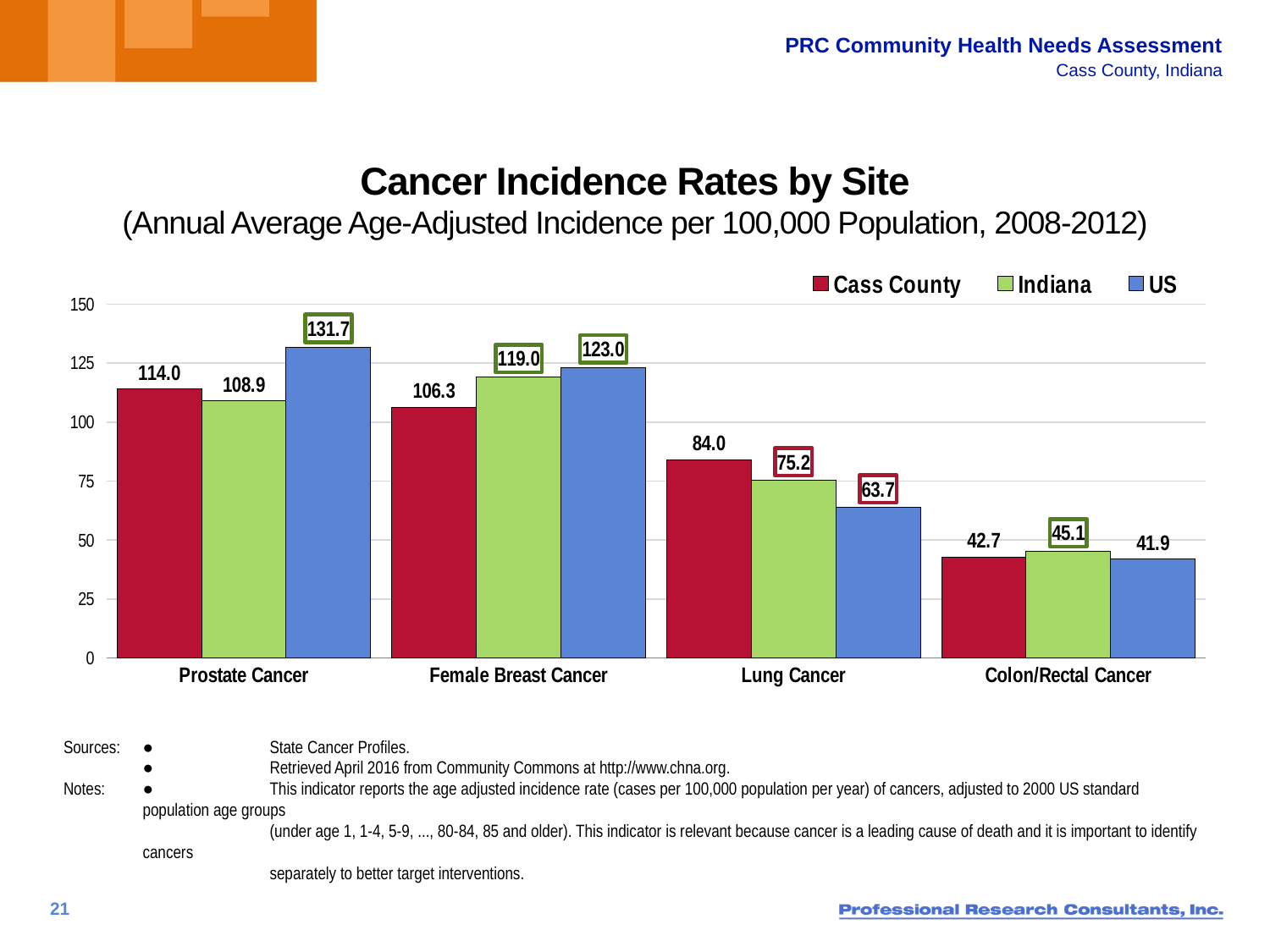
How many series does the legend list? 3 What is the difference between the US and Cass County incidence rates for Prostate Cancer? 17.7 Which series is shown in blue in the legend? US Which cancer site has the lowest US incidence rate? Colon/Rectal Cancer What is the Cass County incidence rate for Prostate Cancer? 114.0 What kind of chart is shown on the slide? Bar chart For Lung Cancer, which is larger: the Cass County rate or the US rate? Cass County How many cancer sites are shown on the x axis? 4 Which cancer site has the highest Cass County incidence rate? Prostate Cancer What is the Indiana incidence rate for Lung Cancer? 75.2 Is the Indiana incidence rate for Female Breast Cancer greater or less than 100? greater What is the US incidence rate for Female Breast Cancer? 123.0